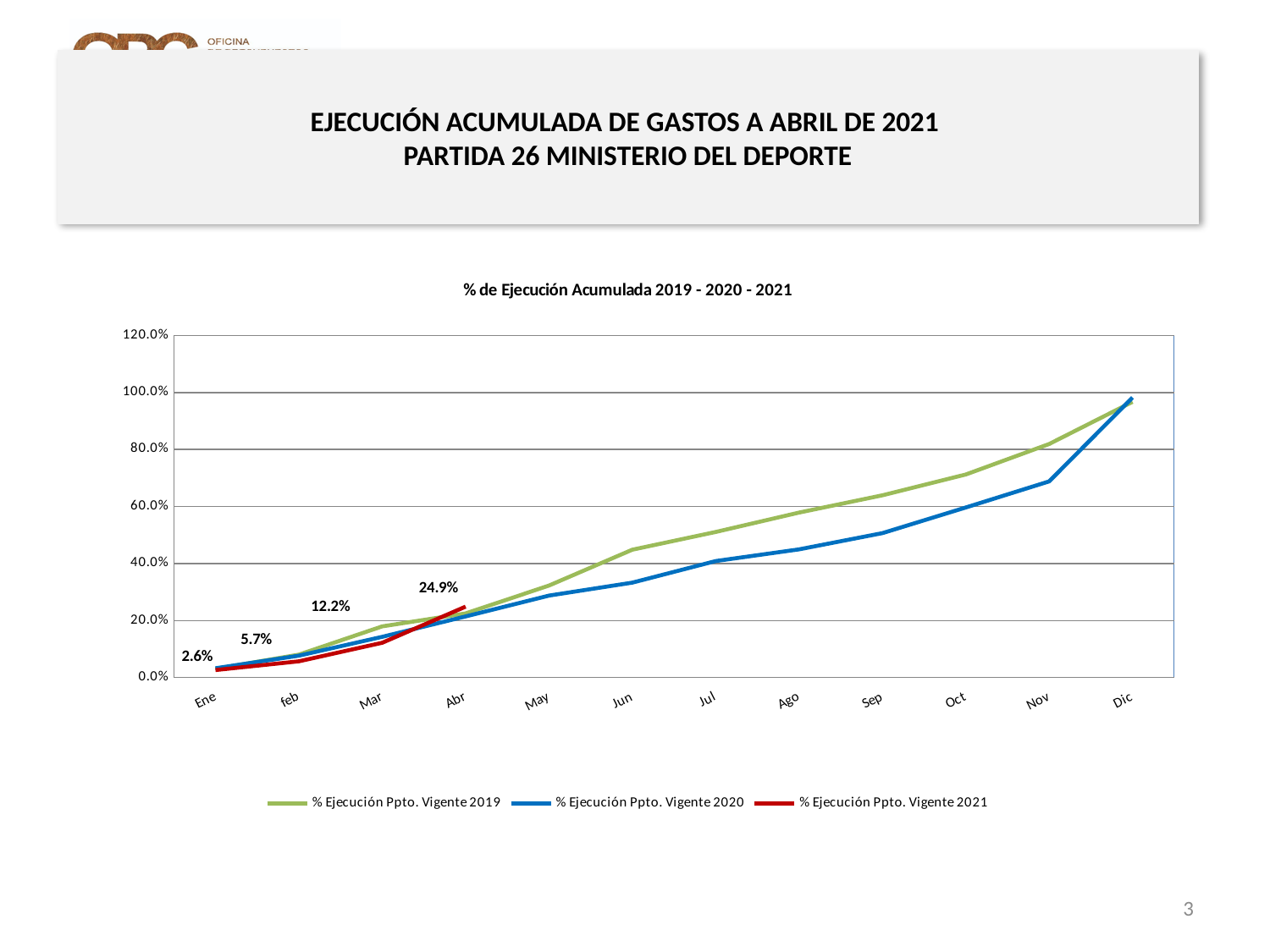
How many months are shown on the x axis? 12 How many series does the legend list? 3 What is the value of % Ejecución Ppto. Vigente 2021 for Abr? 24.9% Is the value for % Ejecución Ppto. Vigente 2020 in Nov greater or less than 80%? less In Nov, which series is higher: % Ejecución Ppto. Vigente 2019 or % Ejecución Ppto. Vigente 2020? % Ejecución Ppto. Vigente 2019 What is the value of % Ejecución Ppto. Vigente 2021 for Mar? 12.2% What kind of chart is shown on the slide? Line chart What is the title of the chart? % de Ejecución Acumulada 2019 - 2020 - 2021 What is the value of % Ejecución Ppto. Vigente 2021 for feb? 5.7% What is the difference between the 2021 values for Abr and Mar? 12.7 percentage points Do the values of % Ejecución Ppto. Vigente 2019 rise or fall from Ene to Dic? Rise What is the value of % Ejecución Ppto. Vigente 2021 for Ene? 2.6%